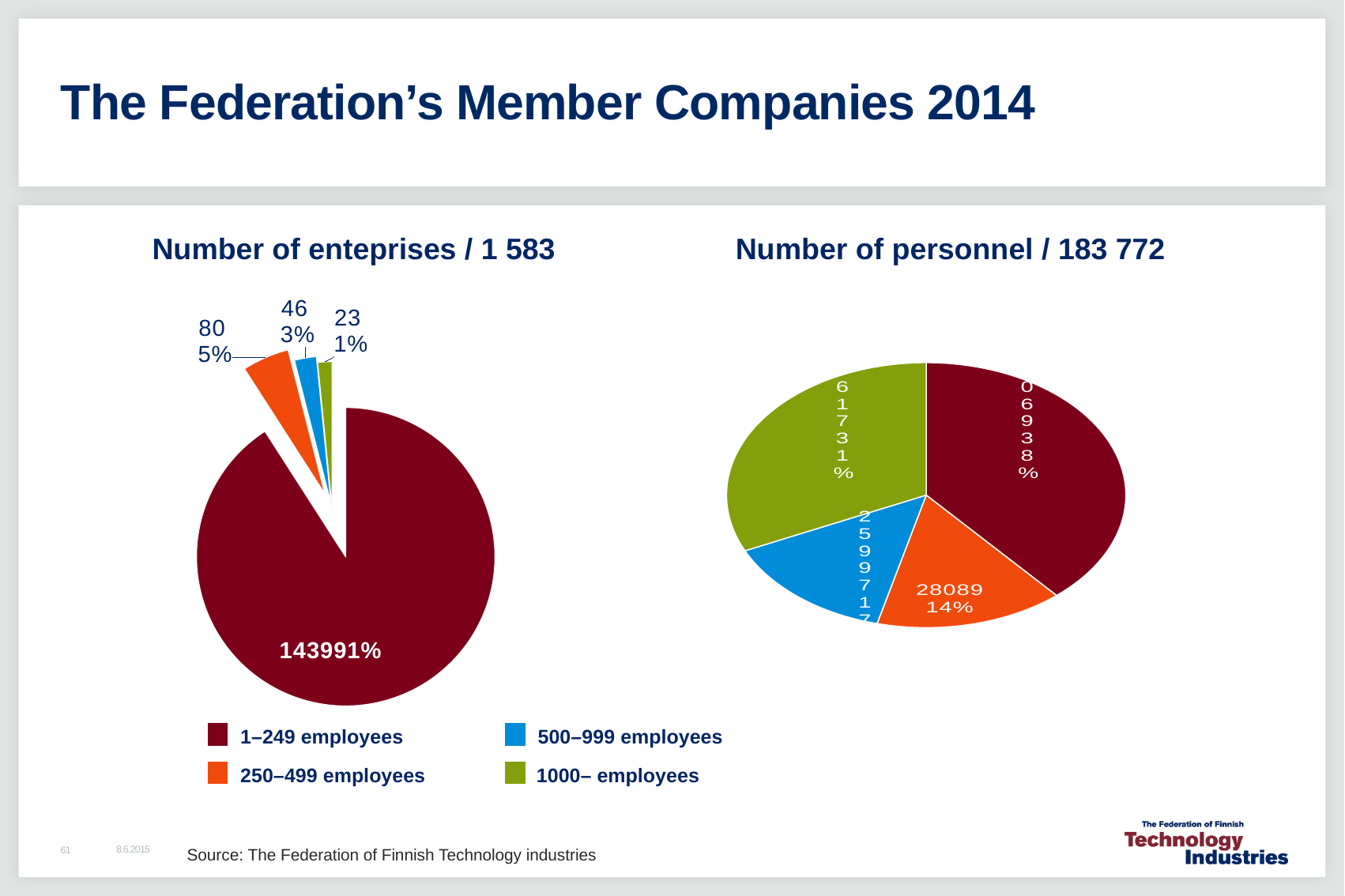
In the 'Number of enteprises' chart, which category has the smallest slice? 1000– employees In the 'Number of enteprises' chart, which category has the largest slice? 1–249 employees In the 'Number of enteprises' chart, which is larger: the slice for 250–499 employees or the slice for 500–999 employees? 250–499 employees In the 'Number of enteprises' chart, what is the difference between the number of enterprises with 250–499 employees and those with 500–999 employees? 34 What kind of chart is used for 'Number of enteprises / 1 583'? pie chart In the 'Number of personnel' chart, how many personnel are in companies with 250–499 employees? 28089 In the 'Number of enteprises' chart, how many enterprises have 250–499 employees? 80 In the 'Number of enteprises' chart, what share of enterprises have 500–999 employees? 3% How many categories does the legend list for the two pie charts? 4 In the 'Number of enteprises' chart, how many enterprises have 1000– employees? 23 In the 'Number of personnel' chart, which category has the largest slice? 1–249 employees In the 'Number of personnel' chart, what share of personnel is in companies with 250–499 employees? 14%